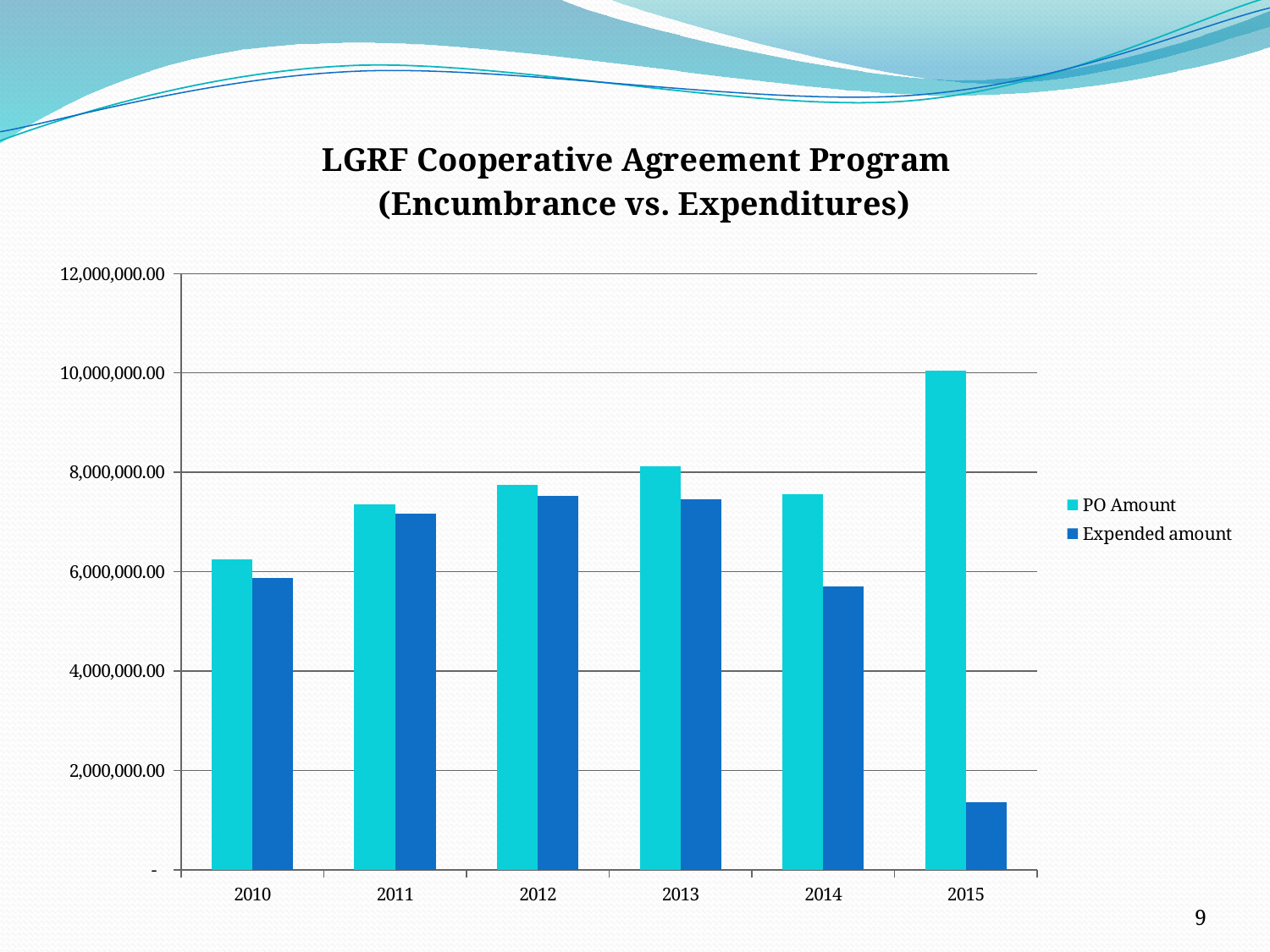
Which year has the lowest PO Amount? 2010 What kind of chart is shown on the slide? Bar chart How many series does the legend list? 2 Is the Expended amount for 2015 greater or less than 2,000,000.00? less How many years are shown on the x axis? 6 In 2015, which is larger, the PO Amount or the Expended amount? PO Amount What are the two entries in the chart's legend? PO Amount and Expended amount Which year has the lowest Expended amount? 2015 Is the Expended amount for 2014 greater or less than 6,000,000.00? less Which year has the highest PO Amount? 2015 Does the PO Amount rise or fall from 2010 to 2013? Rise Is the PO Amount for 2010 greater or less than 6,000,000.00? greater